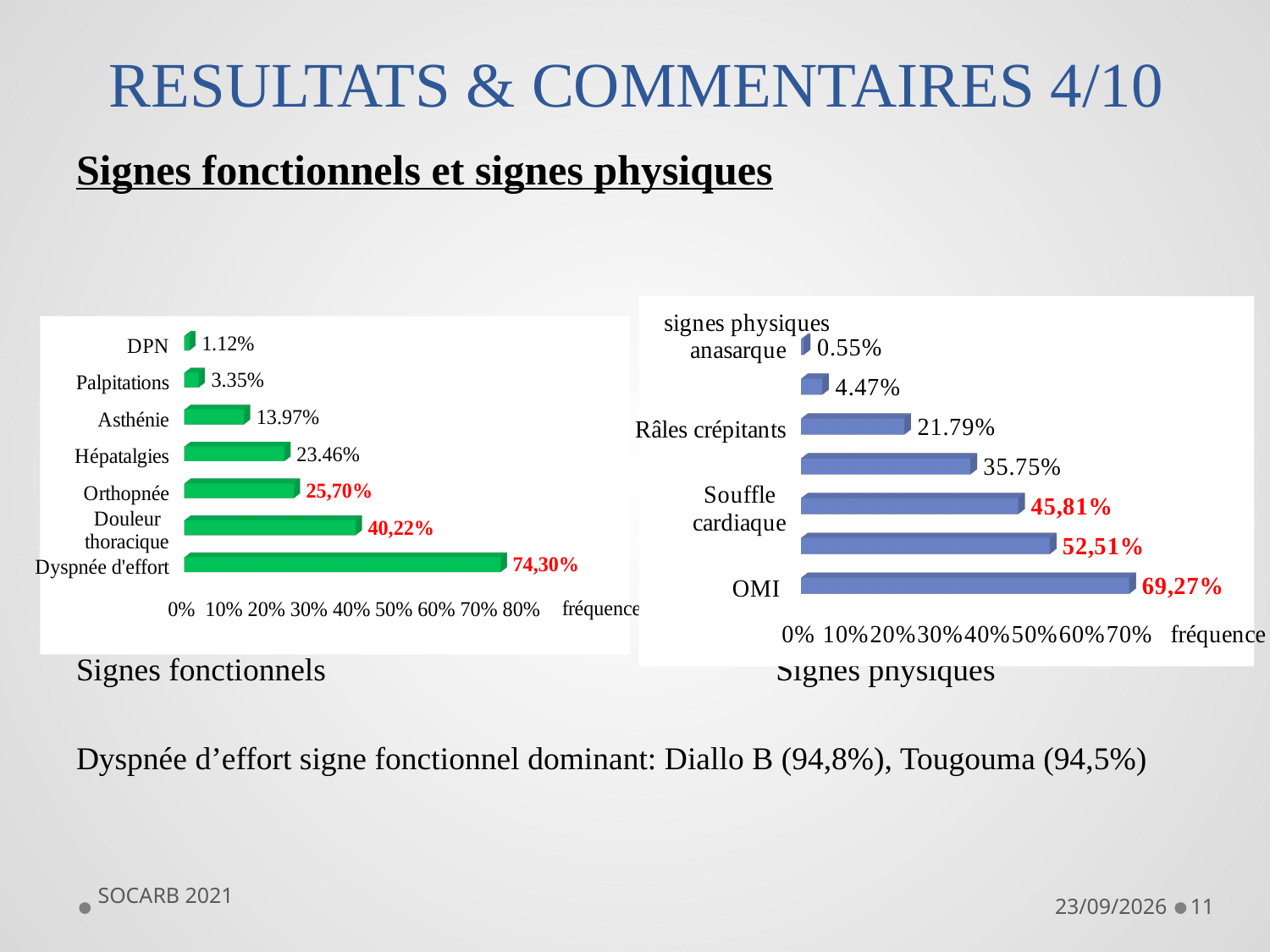
In the Signes physiques chart, which category has the lowest value? anasarque In the Signes physiques chart, what is the value for OMI? 69,27% In the Signes fonctionnels chart, what is the value for Asthénie? 13.97% In the Signes fonctionnels chart, which category has the highest value? Dyspnée d'effort In the Signes physiques chart, which is larger: Souffle cardiaque or Râles crépitants? Souffle cardiaque What type of chart is the Signes fonctionnels chart? Bar chart In the Signes fonctionnels chart, how many categories are plotted? 7 In the Signes fonctionnels chart, what is the value for Dyspnée d'effort? 74,30% In the Signes physiques chart, what is the difference between OMI and Souffle cardiaque? 23,46% In the Signes physiques chart, what is the value for Râles crépitants? 21.79% In the Signes fonctionnels chart, which category has the lowest value? DPN In the Signes fonctionnels chart, what is the difference between Dyspnée d'effort and Douleur thoracique? 34,08%